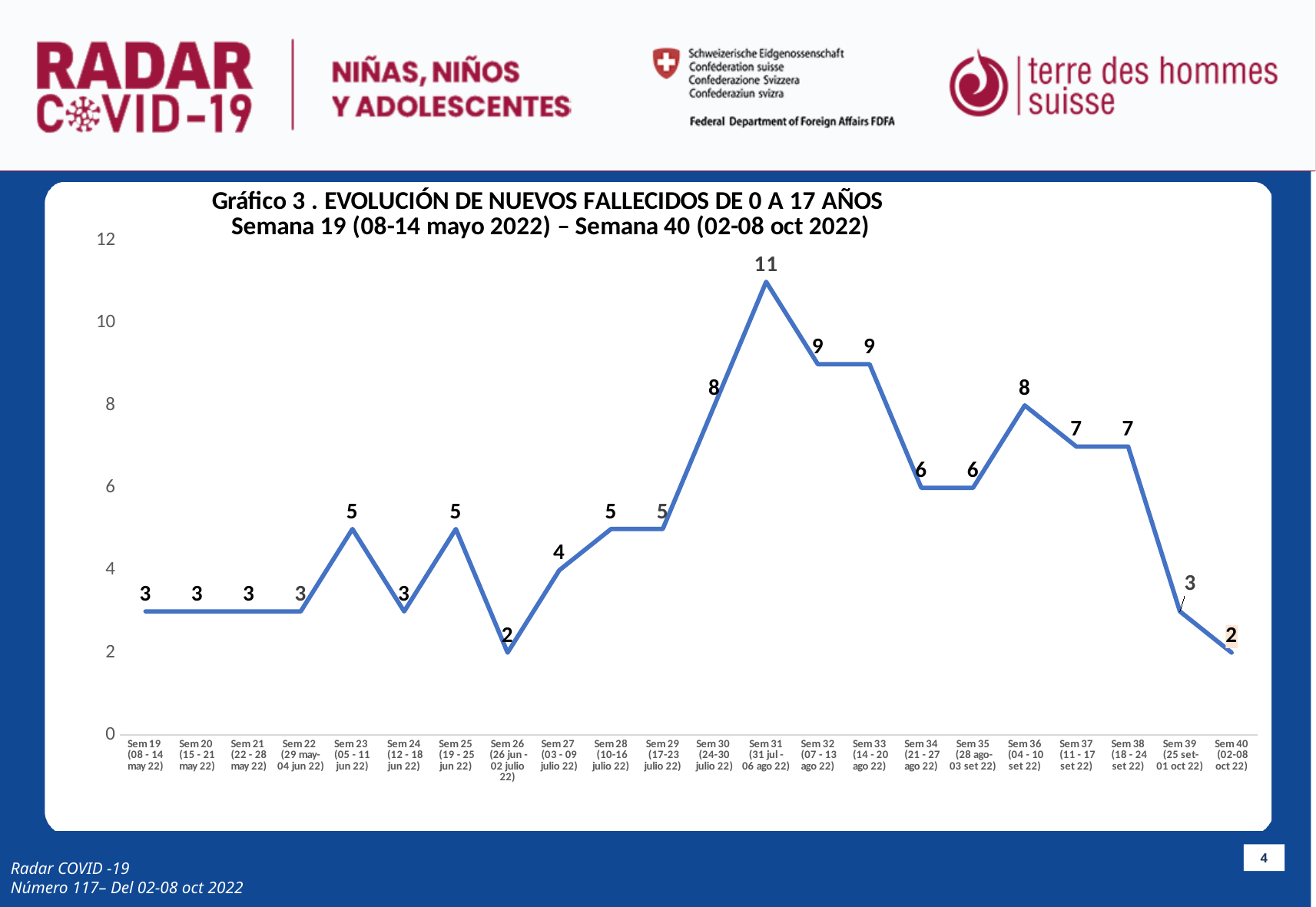
What is the lowest value plotted on the chart? 2 What type of chart is shown on the slide? line chart What is the difference between the values for Sem 38 and Sem 39? 4 What is the value for Sem 30 (24-30 julio 22)? 8 Which is larger, the value for Sem 36 or the value for Sem 37? Sem 36 What is the difference between the values for Sem 31 and Sem 32? 2 Which week has the highest value? Sem 31 (31 jul - 06 ago 22) How many weeks are plotted on the x axis? 22 What is the value for Sem 27 (03 - 09 julio 22)? 4 What is the value for Sem 40 (02-08 oct 22)? 2 What is the value for Sem 31 (31 jul - 06 ago 22)? 11 Do the values rise or fall from Sem 38 to Sem 40? fall